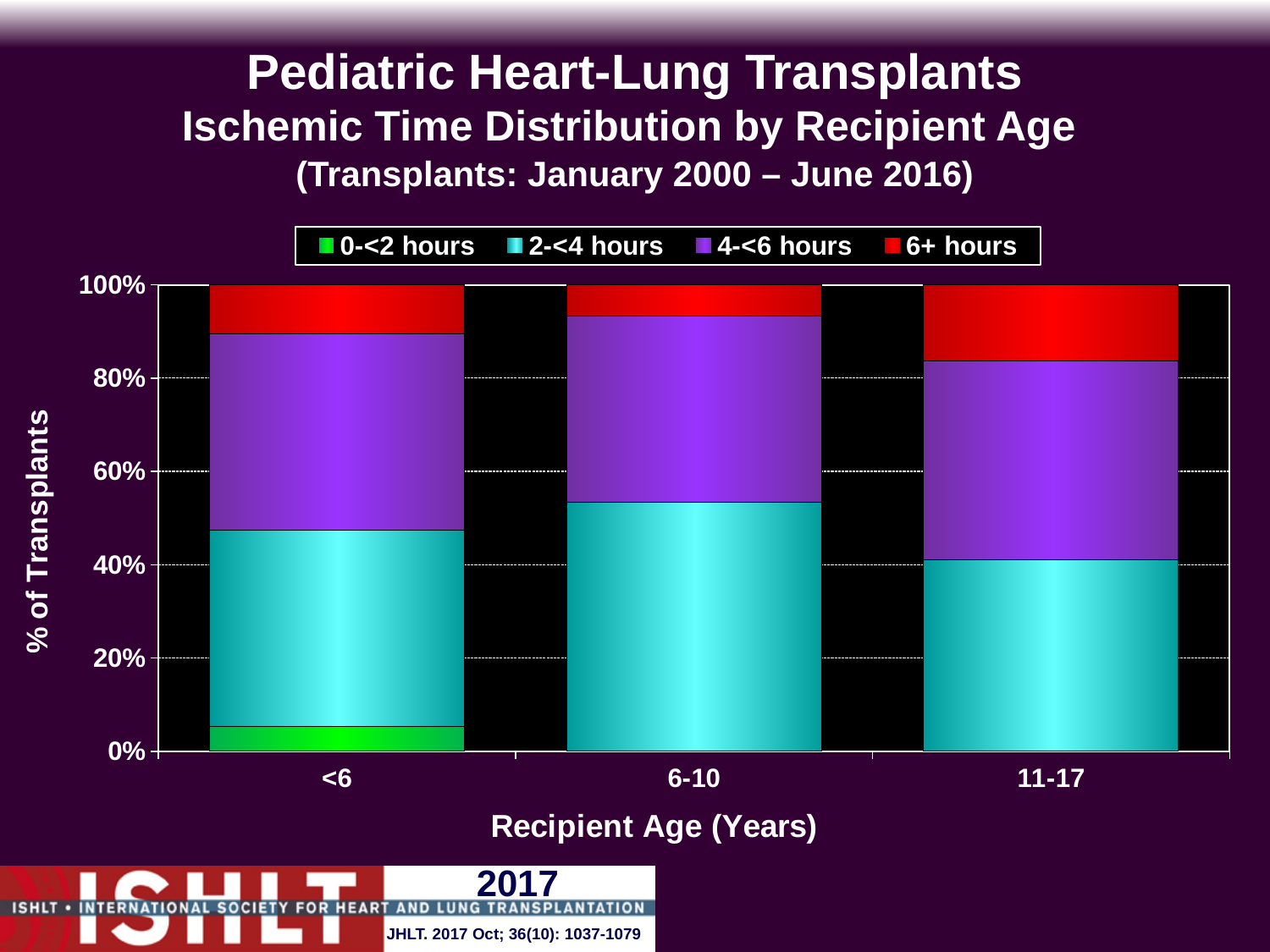
Is the 6+ hours share larger for the 11-17 group or the 6-10 group? 11-17 Is the 4-<6 hours share for the 11-17 group greater or less than 60%? less Is the 2-<4 hours share larger for the 6-10 group or the 11-17 group? 6-10 What is the title of the y axis? % of Transplants Which recipient age group is the only one with a visible 0-<2 hours segment? <6 Is the 2-<4 hours share for the 6-10 group greater or less than 40%? greater Is the 6+ hours share for the 11-17 group greater or less than 20%? less Which recipient age group has the largest 2-<4 hours share? 6-10 How many recipient age groups are shown on the x axis? 3 How many series does the legend list? 4 Which recipient age group has the largest 6+ hours share? 11-17 What kind of chart is shown on the slide? Stacked bar chart